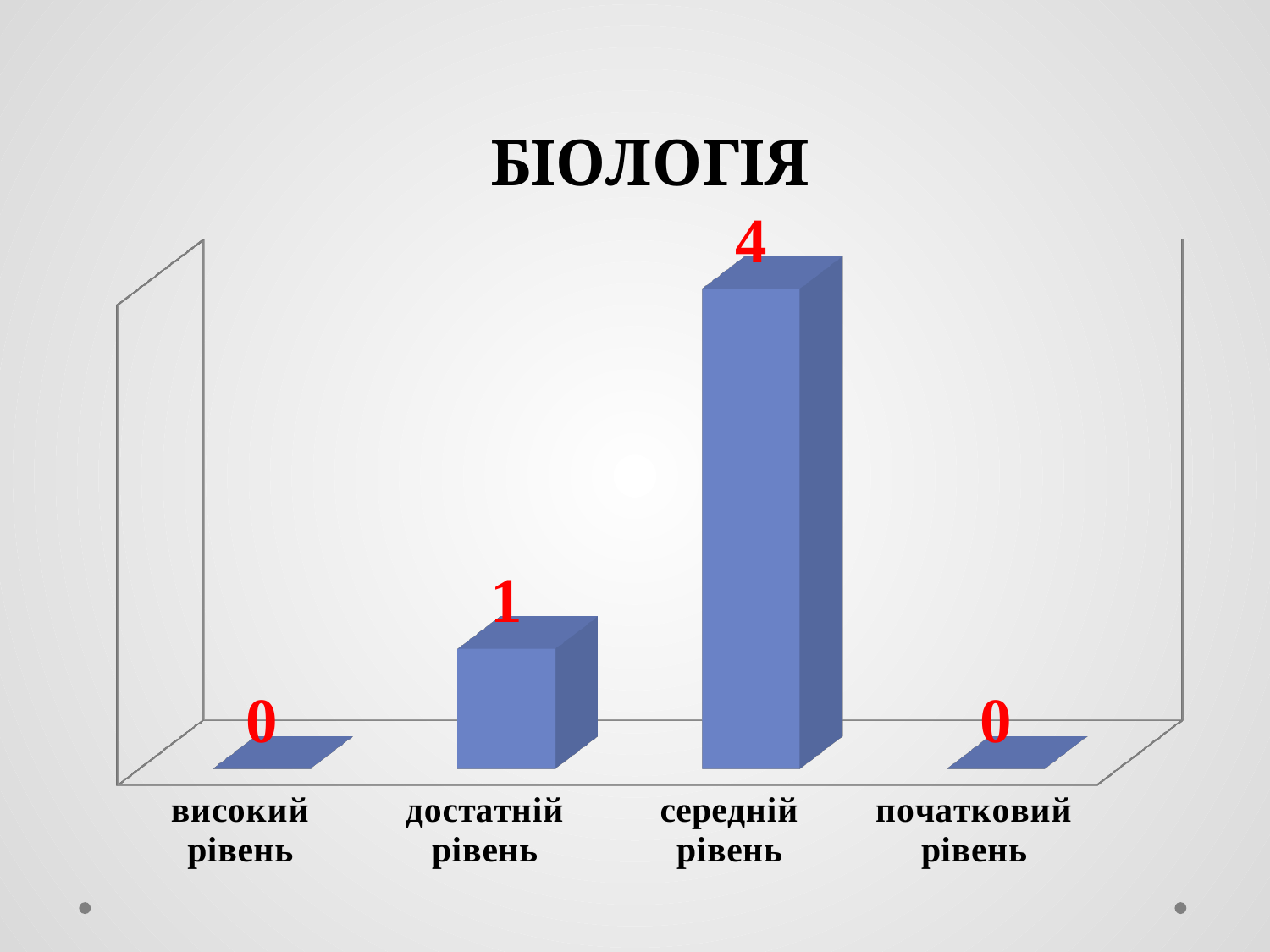
What kind of chart is shown on the slide? bar chart What is the title of the chart? БІОЛОГІЯ Which is larger, the value for достатній рівень or the value for середній рівень? середній рівень Which category has the highest value? середній рівень What is the total of all four values shown? 5 What is the value for середній рівень? 4 What is the value for початковий рівень? 0 What is the value for високий рівень? 0 What is the value for достатній рівень? 1 How many categories are shown on the x axis? 4 What is the difference between the values for середній рівень and достатній рівень? 3 How many categories have a value of 0? 2